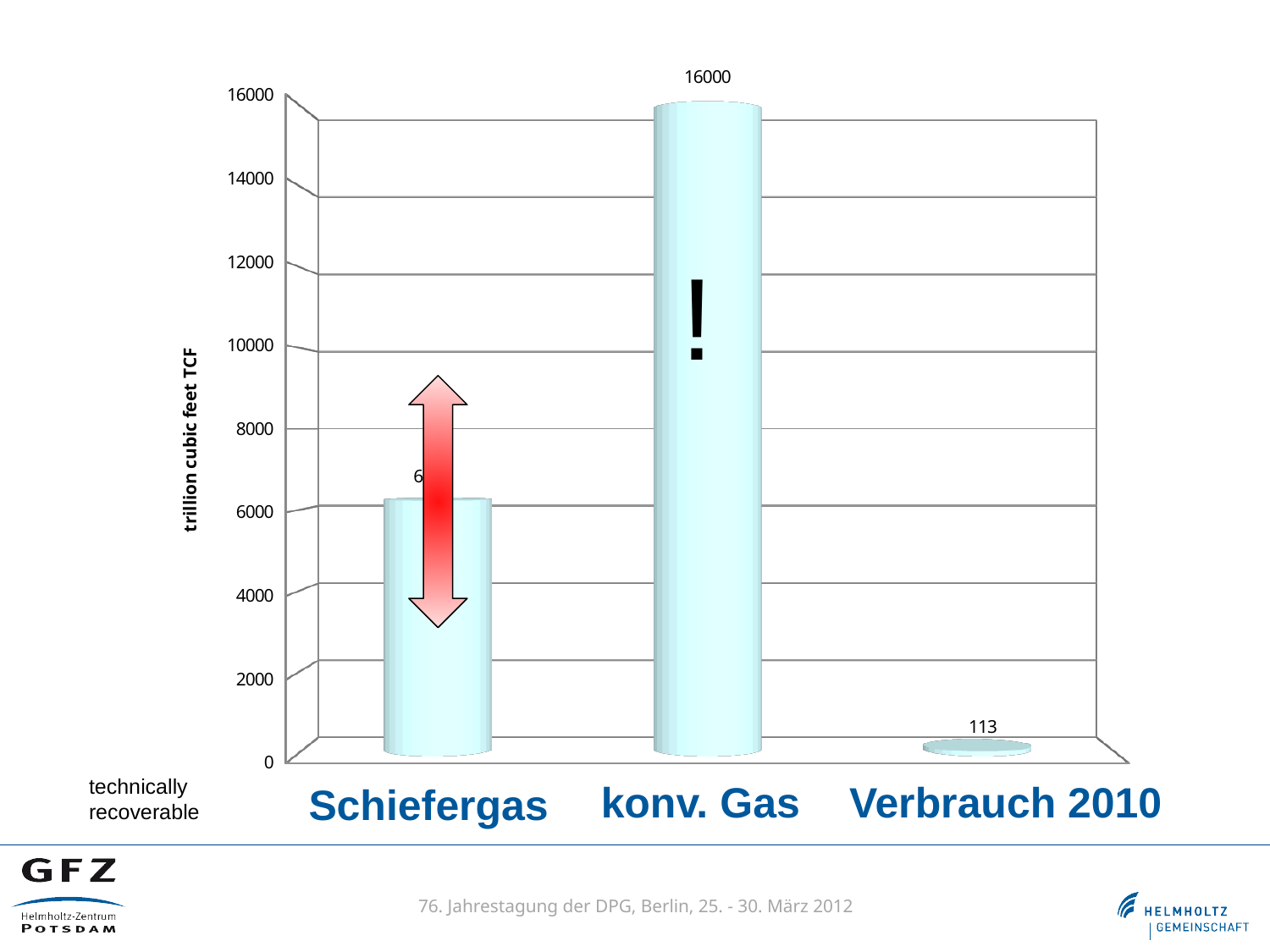
What is the difference between the values for konv. Gas and Verbrauch 2010? 15887 Is the value for Schiefergas greater or less than 8000? less Which is larger, the value for Schiefergas or the value for Verbrauch 2010? Schiefergas What is the label of the vertical axis? trillion cubic feet TCF Which category has the lowest value? Verbrauch 2010 What kind of chart is shown on the slide? bar chart Which category has the highest value? konv. Gas What is the value for Verbrauch 2010? 113 What is the value for konv. Gas? 16000 How many categories are shown on the chart? 3 Is the value for Schiefergas greater or less than 4000? greater Which is larger, the value for Schiefergas or the value for konv. Gas? konv. Gas